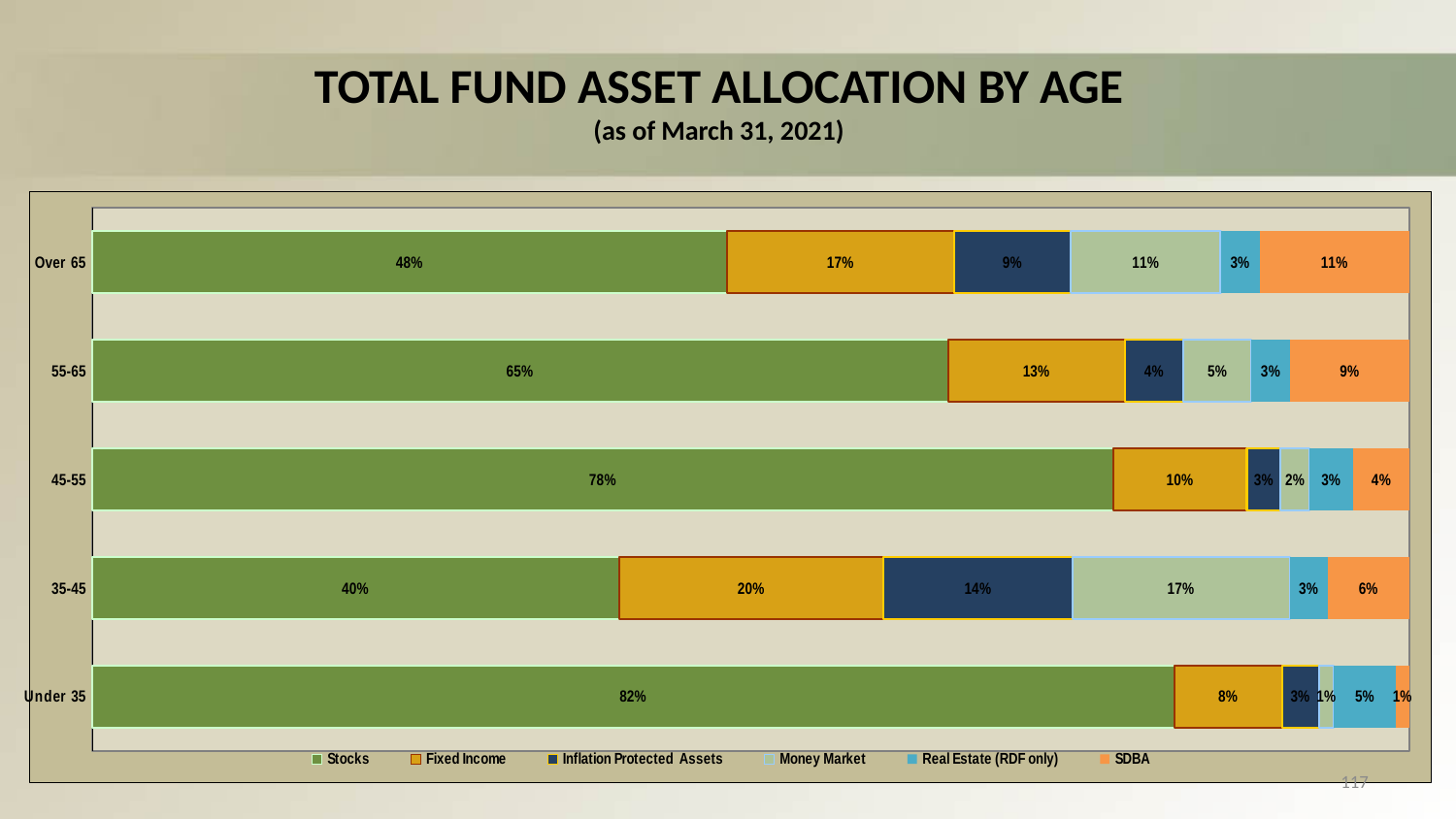
What is the Money Market allocation for the 55-65 age group? 5% Which age group has a larger Inflation Protected Assets allocation, 35-45 or 45-55? 35-45 How many series does the legend list? 6 What is the Fixed Income allocation for the 35-45 age group? 20% How many percentage points higher is the Stocks allocation for the 55-65 group than for the Over 65 group? 17 What percentage of the Over 65 group's assets is allocated to Stocks? 48% As of what date is the asset allocation data shown? March 31, 2021 What is the SDBA allocation for the Under 35 age group? 1% How many age groups are shown in the chart? 5 What kind of chart is shown on the slide? Stacked bar chart Which age group has the highest allocation to Stocks? Under 35 Which age group has the lowest allocation to Stocks? 35-45